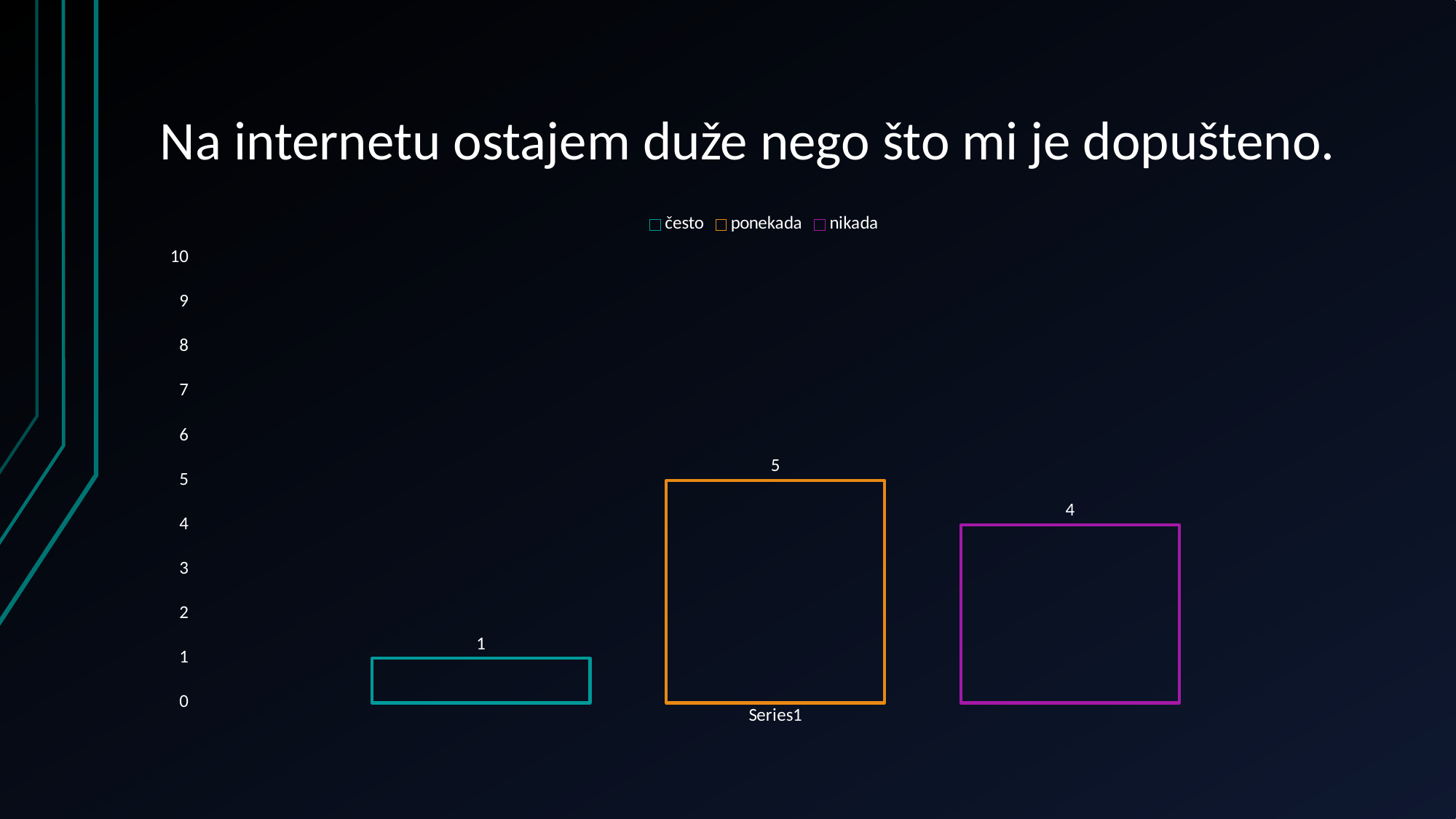
Which series has the highest value? ponekada What is the value for "nikada"? 4 Which series has the lowest value? često What is the difference between the values for "ponekada" and "nikada"? 1 What kind of chart is shown on the slide? bar chart How many series does the legend list? 3 What is the value for "često"? 1 Which is larger, the value for "nikada" or the value for "često"? nikada What is the title of the slide? Na internetu ostajem duže nego što mi je dopušteno. Is the value for "ponekada" greater or less than 3? greater What is the difference between the values for "ponekada" and "često"? 4 What is the value for "ponekada"? 5